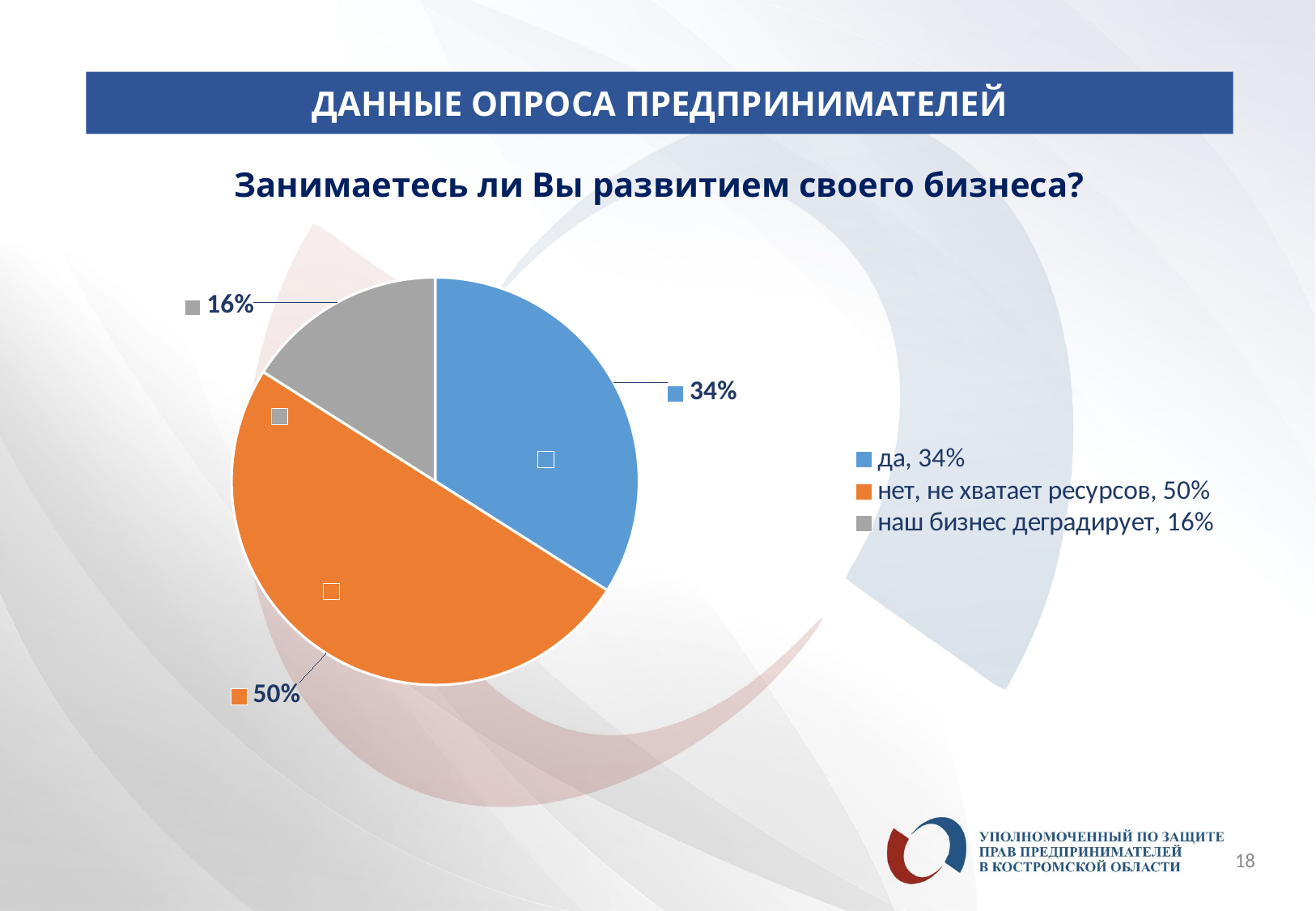
What share of respondents answered "нет, не хватает ресурсов"? 50% What share of respondents answered "наш бизнес деградирует"? 16% What is the difference in percentage points between "нет, не хватает ресурсов" and "да"? 16 What colour is the slice for "нет, не хватает ресурсов"? orange What is the difference in percentage points between "да" and "наш бизнес деградирует"? 18 How many slices does the pie chart have? 3 Which answer has the largest share of the pie? нет, не хватает ресурсов Which answer has the smallest share of the pie? наш бизнес деградирует Which is larger: the share for "да" or the share for "наш бизнес деградирует"? да What kind of chart is shown on the slide? pie chart What question is the pie chart answering, according to the chart title? Занимаетесь ли Вы развитием своего бизнеса? What share of respondents answered "да"? 34%